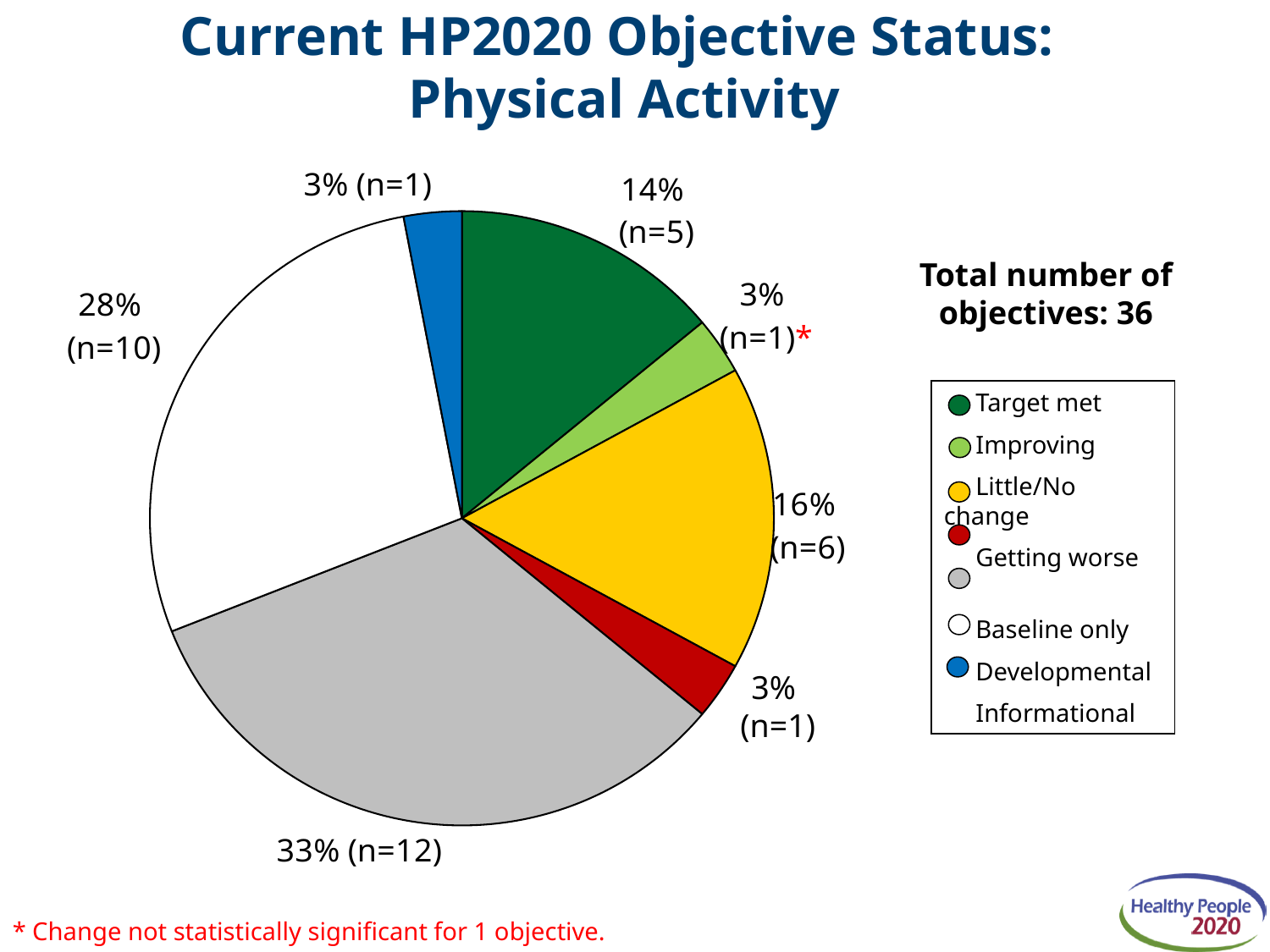
How many objectives are in the "Target met" category? 5 What percentage of objectives have the status "Target met"? 14% Which has a larger share: "Target met" or "Little/No change"? Little/No change What percentage does the largest slice of the pie represent? 33% What percentage of objectives show "Little/No change"? 16% How many objectives are in the "Little/No change" category? 6 How many slices does the pie chart have? 7 How many more objectives are in "Little/No change" than in "Target met"? 1 How many entries does the legend list? 7 How many objectives does the largest slice (gray) represent? 12 What type of chart is shown on the slide? Pie chart What is the total number of objectives stated on the slide? 36